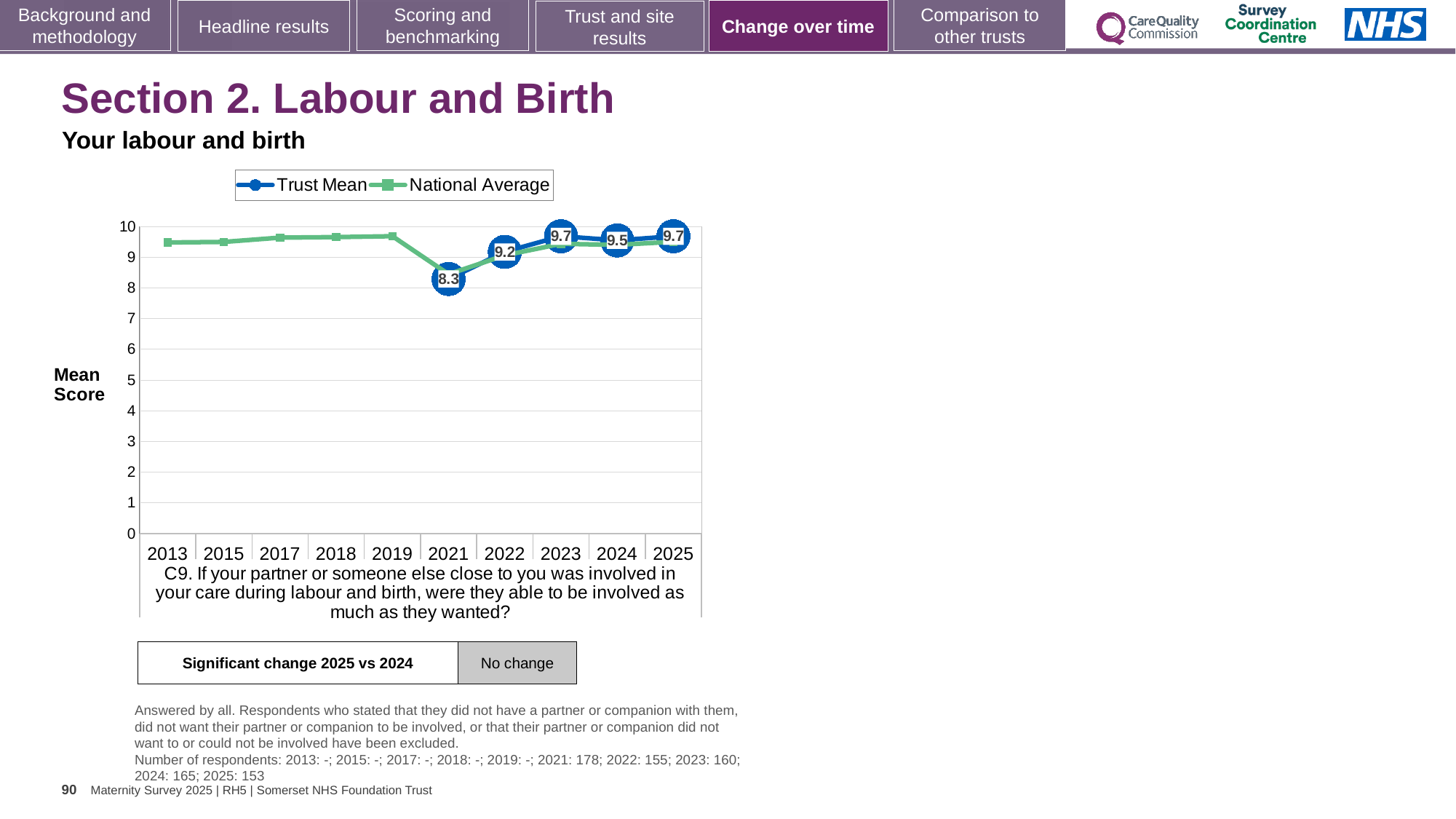
How many years are shown on the x axis? 10 In which year is the Trust Mean score lowest? 2021 What is the Trust Mean score for 2024? 9.5 What is the Trust Mean score for 2022? 9.2 What is the Trust Mean score for 2021? 8.3 Which is larger, the Trust Mean score for 2022 or for 2024? 2024 Is the National Average value for 2013 greater or less than 9? greater What is the Trust Mean score for 2025? 9.7 What is the difference between the Trust Mean scores for 2022 and 2021? 0.9 Does the Trust Mean score rise or fall from 2021 to 2023? rise How many series does the legend list? 2 What kind of chart is shown on the slide? line chart